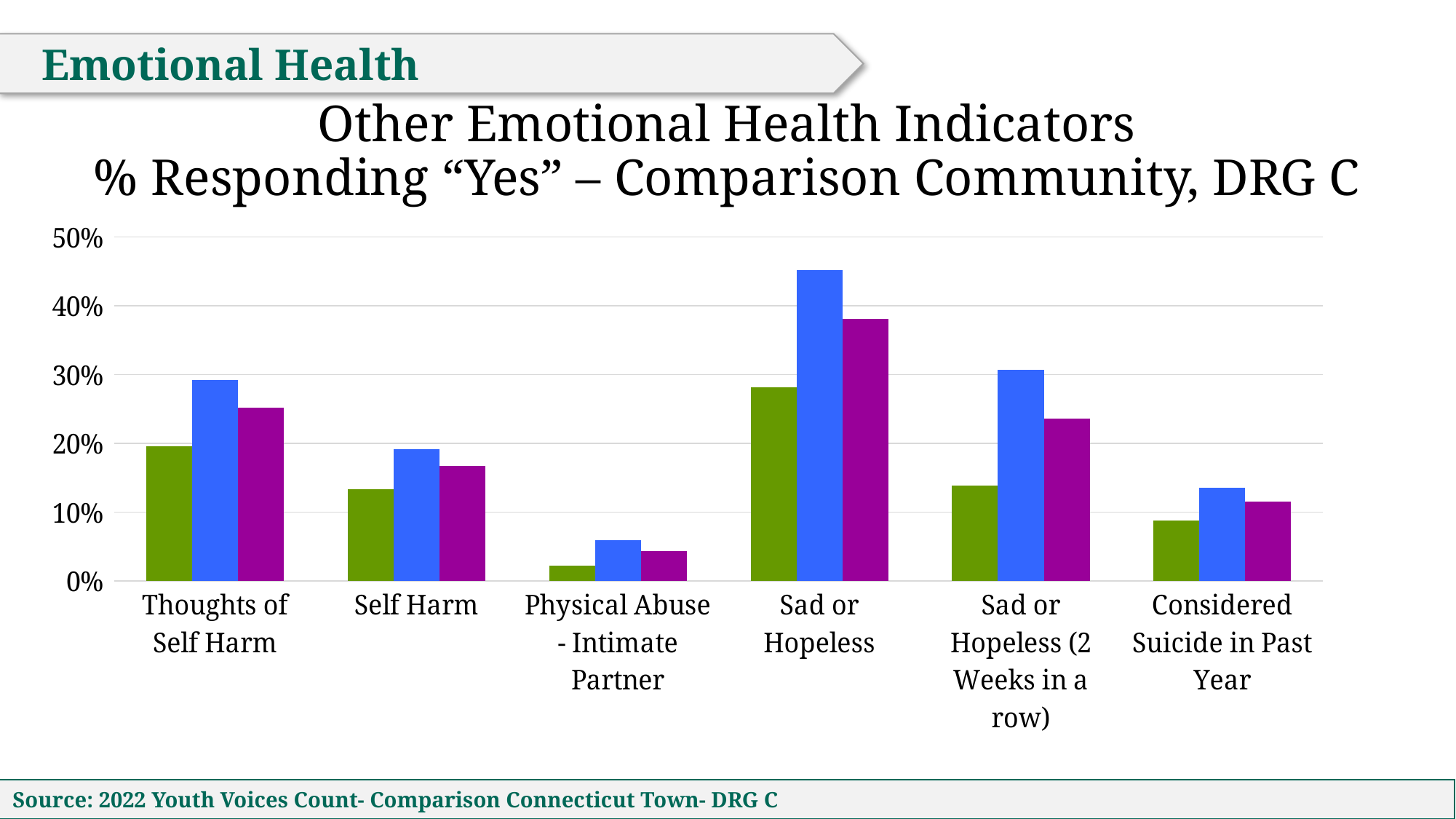
How many categories are shown along the x axis of the chart? 6 What three colours are used for the bars in the chart? Green, blue and purple Is the purple bar for Sad or Hopeless (2 Weeks in a row) greater or less than 20%? greater Which category has the tallest bar in the chart? Sad or Hopeless Which is larger: the purple bar for Sad or Hopeless or the purple bar for Considered Suicide in Past Year? Sad or Hopeless What kind of chart is shown on the slide? Bar chart Which category has the shortest bars in the chart? Physical Abuse - Intimate Partner Which is larger: the blue bar for Thoughts of Self Harm or the blue bar for Self Harm? Thoughts of Self Harm What is the title of the chart? Other Emotional Health Indicators % Responding "Yes" – Comparison Community, DRG C Is the blue bar for Physical Abuse - Intimate Partner greater or less than 10%? less Is the blue bar for Sad or Hopeless greater or less than 40%? greater